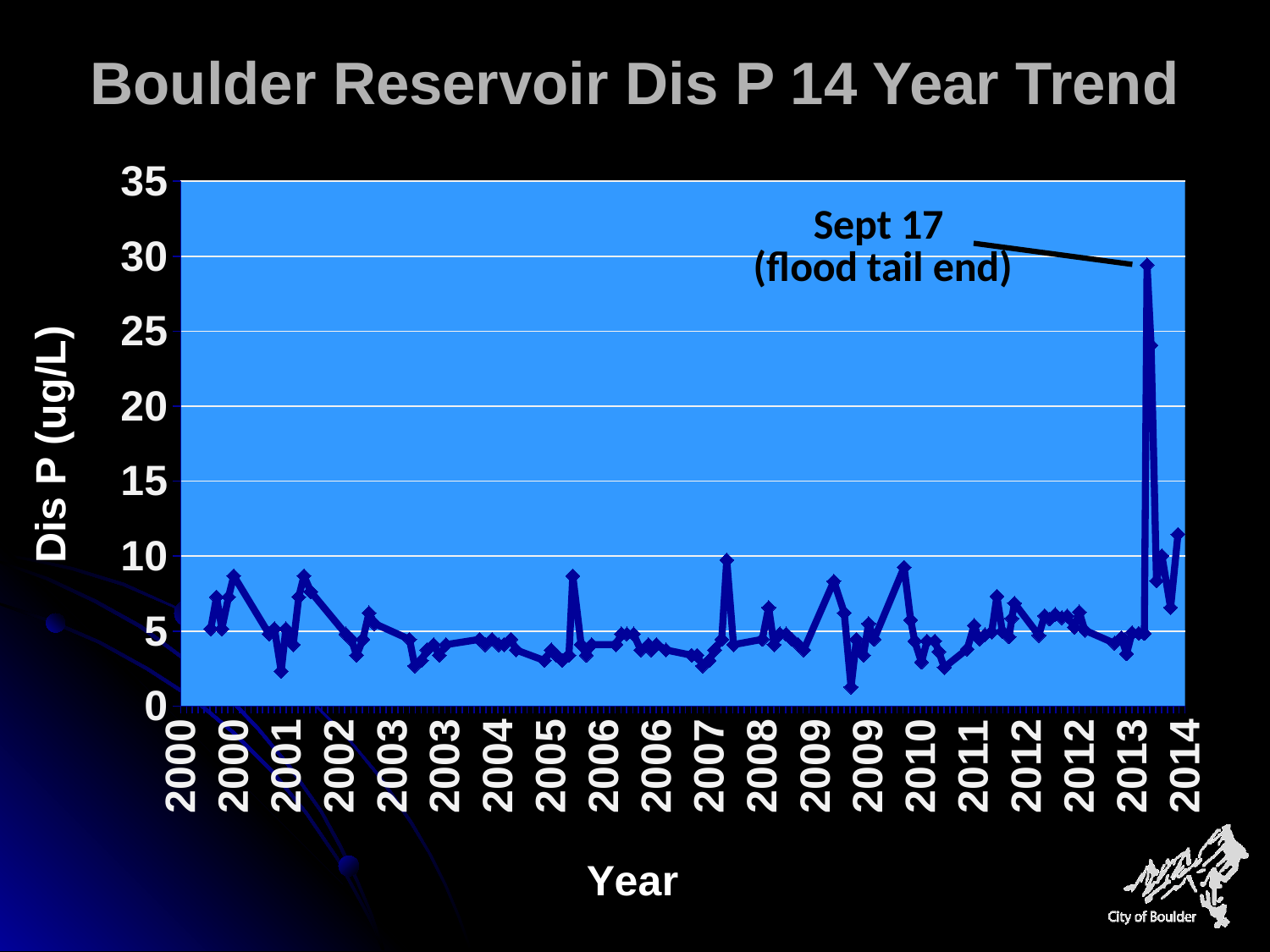
Which is larger, the peak value in 2013 or the peak value in 2007? 2013 What kind of chart is shown on the slide? Line chart What is the title of the chart? Boulder Reservoir Dis P 14 Year Trend Is the lowest value in 2009 greater or less than 5? less Is the value at the start of 2000 greater or less than 10? less Is the peak value in 2013 greater or less than 25? greater In which year does the line reach its highest value? 2013 What event does the annotation attribute the 2013 spike to? Sept 17 (flood tail end) What is the highest tick value shown on the vertical axis? 35